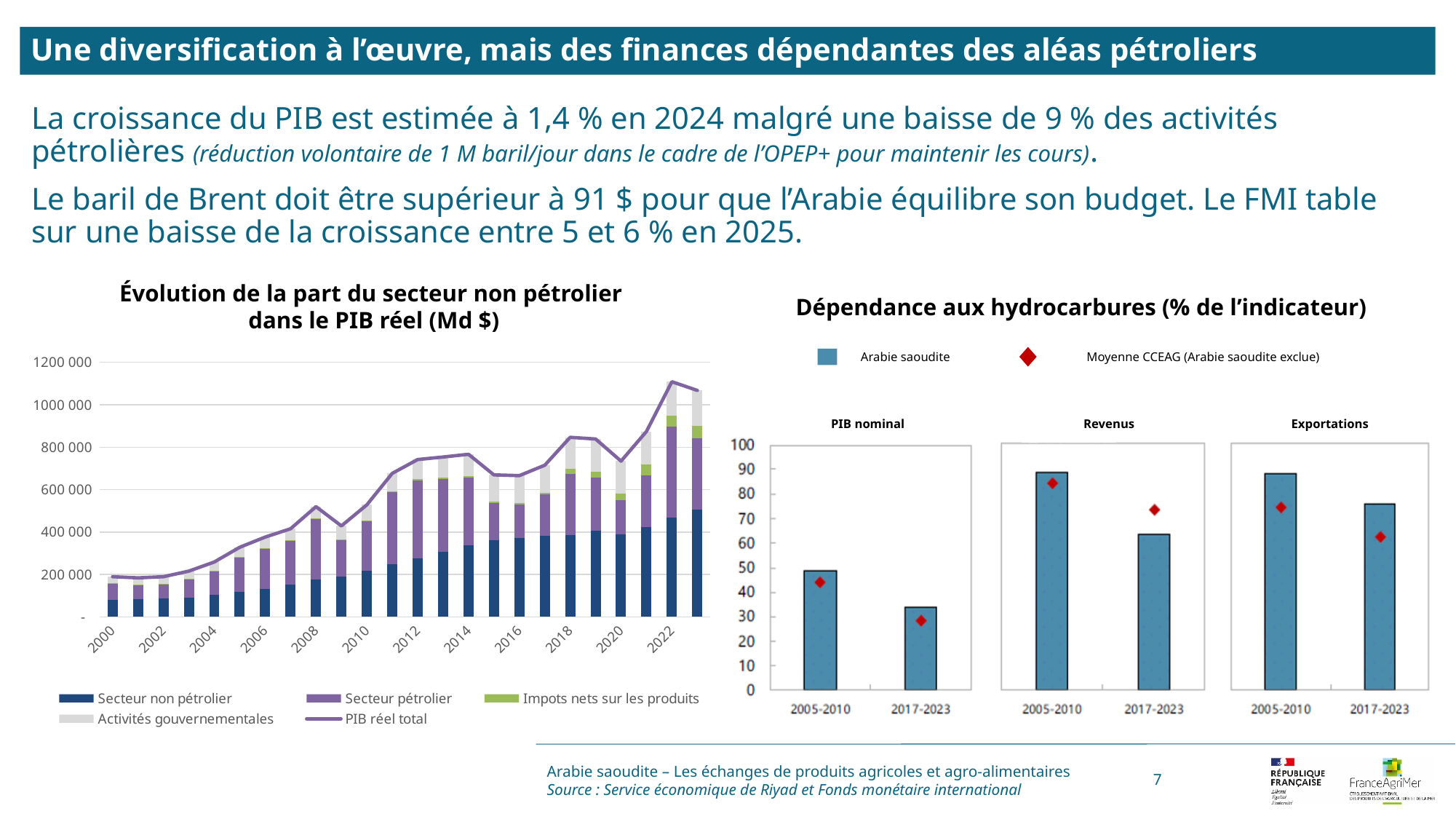
In the left chart 'Évolution de la part du secteur non pétrolier dans le PIB réel', how many series does the legend list? 5 In the left chart 'Évolution de la part du secteur non pétrolier dans le PIB réel', is the PIB réel total for 2022 greater or less than 1 000 000? greater In the left chart 'Évolution de la part du secteur non pétrolier dans le PIB réel', is the Secteur non pétrolier value for 2000 greater or less than 200 000? less In the left chart 'Évolution de la part du secteur non pétrolier dans le PIB réel', which series is drawn as a line rather than bars? PIB réel total In the left chart 'Évolution de la part du secteur non pétrolier dans le PIB réel', which year has the higher PIB réel total, 2022 or 2020? 2022 In the right chart 'Dépendance aux hydrocarbures', is the Arabie saoudite bar for PIB nominal in 2017-2023 greater or less than 40? less In the right chart 'Dépendance aux hydrocarbures', for Exportations, which period has the higher Arabie saoudite bar, 2005-2010 or 2017-2023? 2005-2010 In the right chart 'Dépendance aux hydrocarbures (% de l'indicateur)', how many series does the legend list? 2 What kind of chart is the left chart, 'Évolution de la part du secteur non pétrolier dans le PIB réel (Md $)'? Stacked bar chart with a line In the right chart 'Dépendance aux hydrocarbures (% de l'indicateur)', how many indicators (panels) are shown? 3 In the left chart 'Évolution de la part du secteur non pétrolier dans le PIB réel', does the PIB réel total line generally rise or fall from 2000 to 2023? Rise